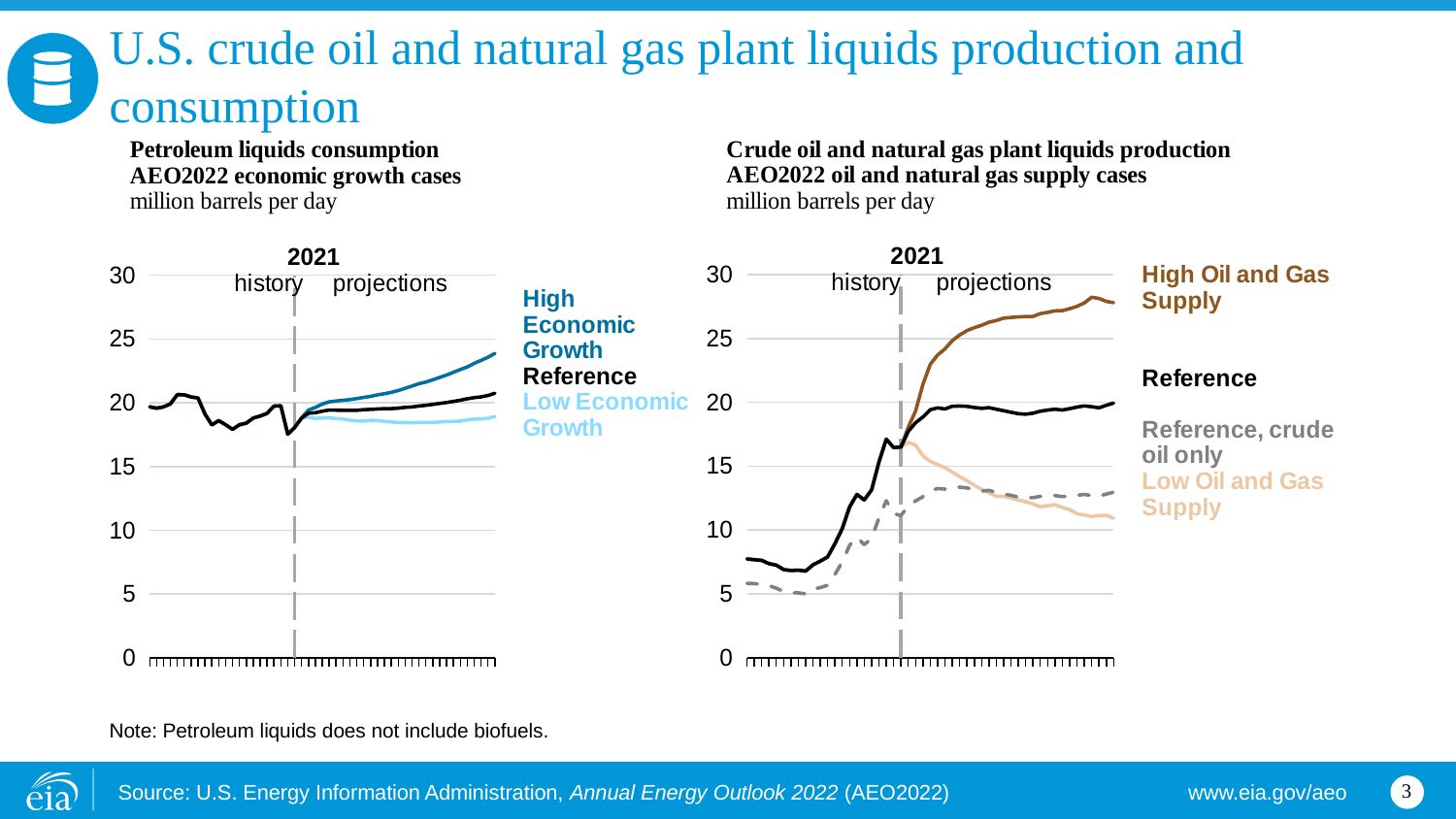
In the 'Crude oil and natural gas plant liquids production' chart on the right, which series is lowest at the end of the projection period? Low Oil and Gas Supply How many series does the legend of the 'Petroleum liquids consumption' chart on the left list? 3 What kind of chart is the 'Petroleum liquids consumption' chart on the left? line chart In the 'Crude oil and natural gas plant liquids production' chart on the right, is the value for High Oil and Gas Supply at the end of the projection period greater or less than 25? greater In the 'Crude oil and natural gas plant liquids production' chart on the right, does the Low Oil and Gas Supply series rise or fall over the projection period? fall In the 'Petroleum liquids consumption' chart on the left, is the value for Low Economic Growth at the end of the projection period greater or less than 20? less In the 'Petroleum liquids consumption' chart on the left, does the High Economic Growth series rise or fall over the projection period? rise How many series does the legend of the 'Crude oil and natural gas plant liquids production' chart on the right list? 4 What unit is used on the y axis of both charts? million barrels per day In the 'Petroleum liquids consumption' chart on the left, is the value for High Economic Growth at the end of the projection period greater or less than 20? greater In the 'Crude oil and natural gas plant liquids production' chart on the right, which series is highest at the end of the projection period? High Oil and Gas Supply